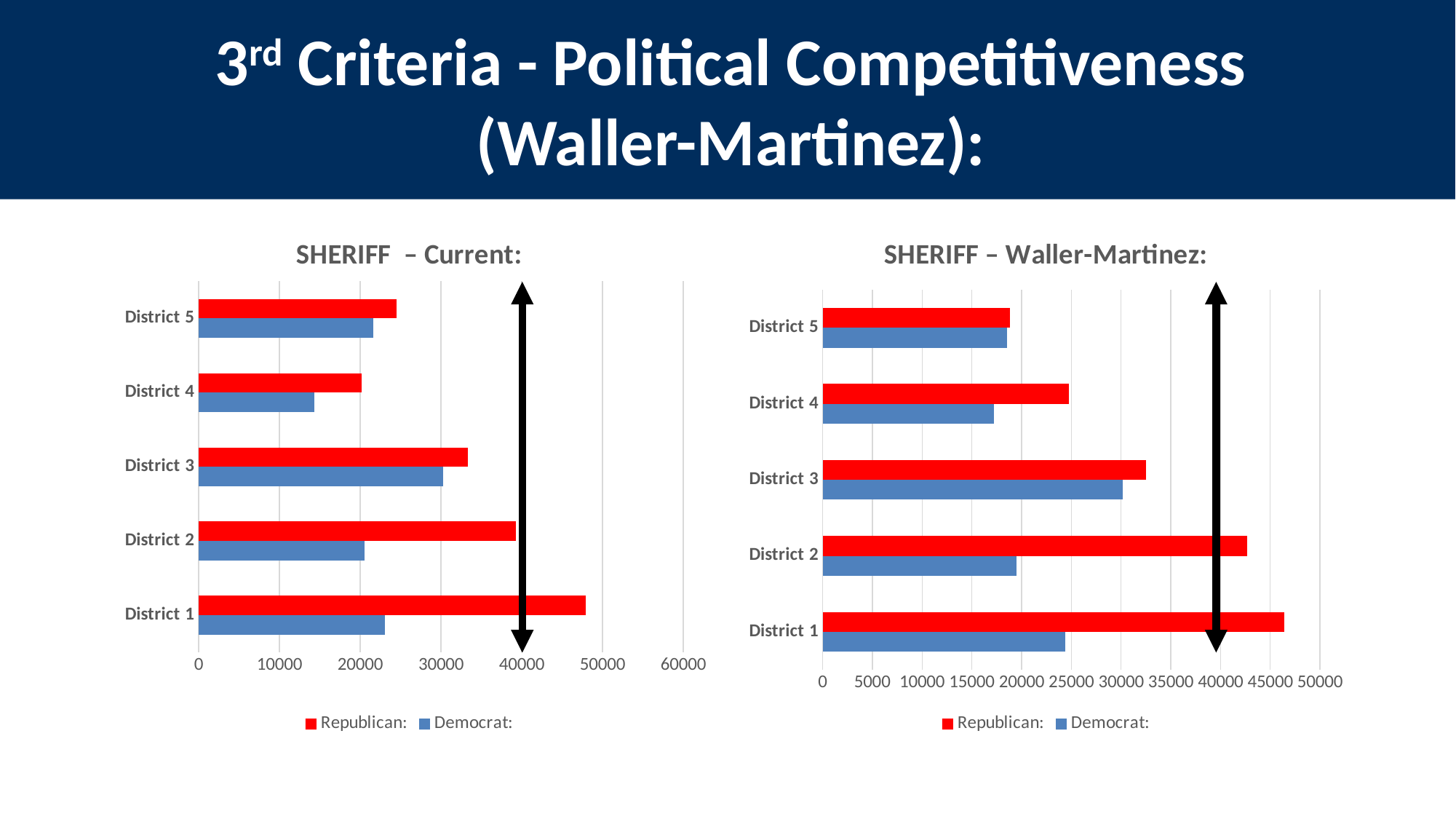
On the SHERIFF – Waller-Martinez chart, which district has the lowest Republican value? District 5 How many districts are shown on the SHERIFF – Waller-Martinez chart? 5 On the SHERIFF – Waller-Martinez chart, which is larger for District 2: the Republican value or the Democrat value? Republican On the SHERIFF – Waller-Martinez chart, is the Republican value for District 2 greater or less than 40000? greater On the SHERIFF – Current chart, which district has the highest Republican value? District 1 On the SHERIFF – Current chart, is the Democrat value for District 4 greater or less than 20000? less What kind of chart is the SHERIFF – Current chart? bar chart On the SHERIFF – Current chart, which district has the lowest Democrat value? District 4 How many series does the legend of the SHERIFF – Current chart list? 2 On the SHERIFF – Current chart, is the Republican value for District 1 greater or less than 40000? greater On the SHERIFF – Waller-Martinez chart, which district has the highest Democrat value? District 3 Which colour represents the Democrat series on the SHERIFF – Current chart? blue